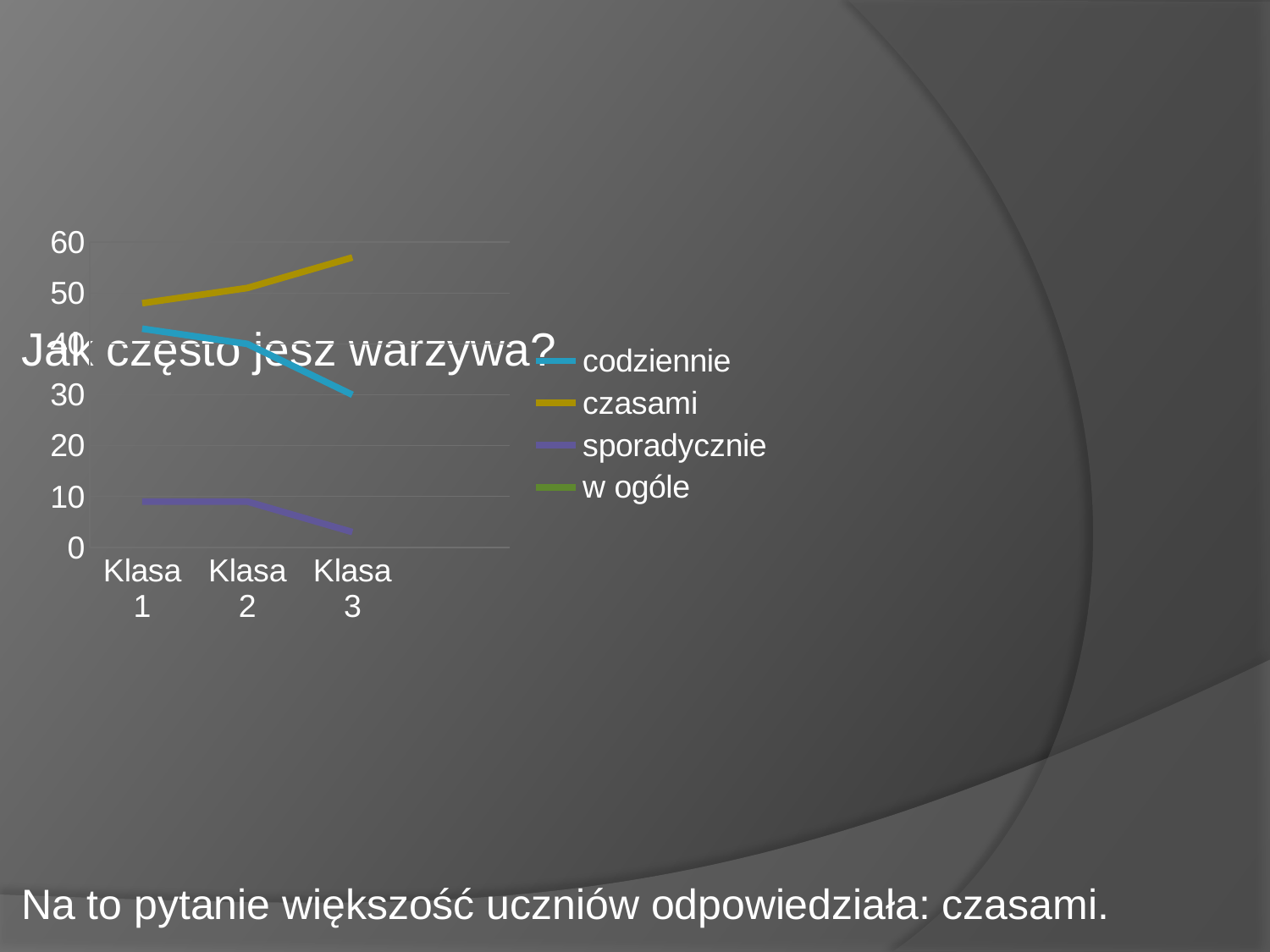
Is the value for 'czasami' at Klasa 3 greater or less than 50? greater At Klasa 3, which is larger: the value for 'czasami' or the value for 'codziennie'? czasami Is the value for 'sporadycznie' at Klasa 1 greater or less than 20? less Is the value for 'codziennie' at Klasa 3 greater or less than 40? less Which series has the highest value at Klasa 3? czasami Does the value for the 'codziennie' series rise or fall from Klasa 1 to Klasa 3? fall Does the value for the 'czasami' series rise or fall from Klasa 1 to Klasa 3? rise How many series does the chart's legend list? 4 How many categories are shown on the x axis of the chart? 3 Which legend entry is drawn in yellow? czasami What kind of chart is shown on the slide? line chart Which of the plotted series has the lowest value at Klasa 2? sporadycznie